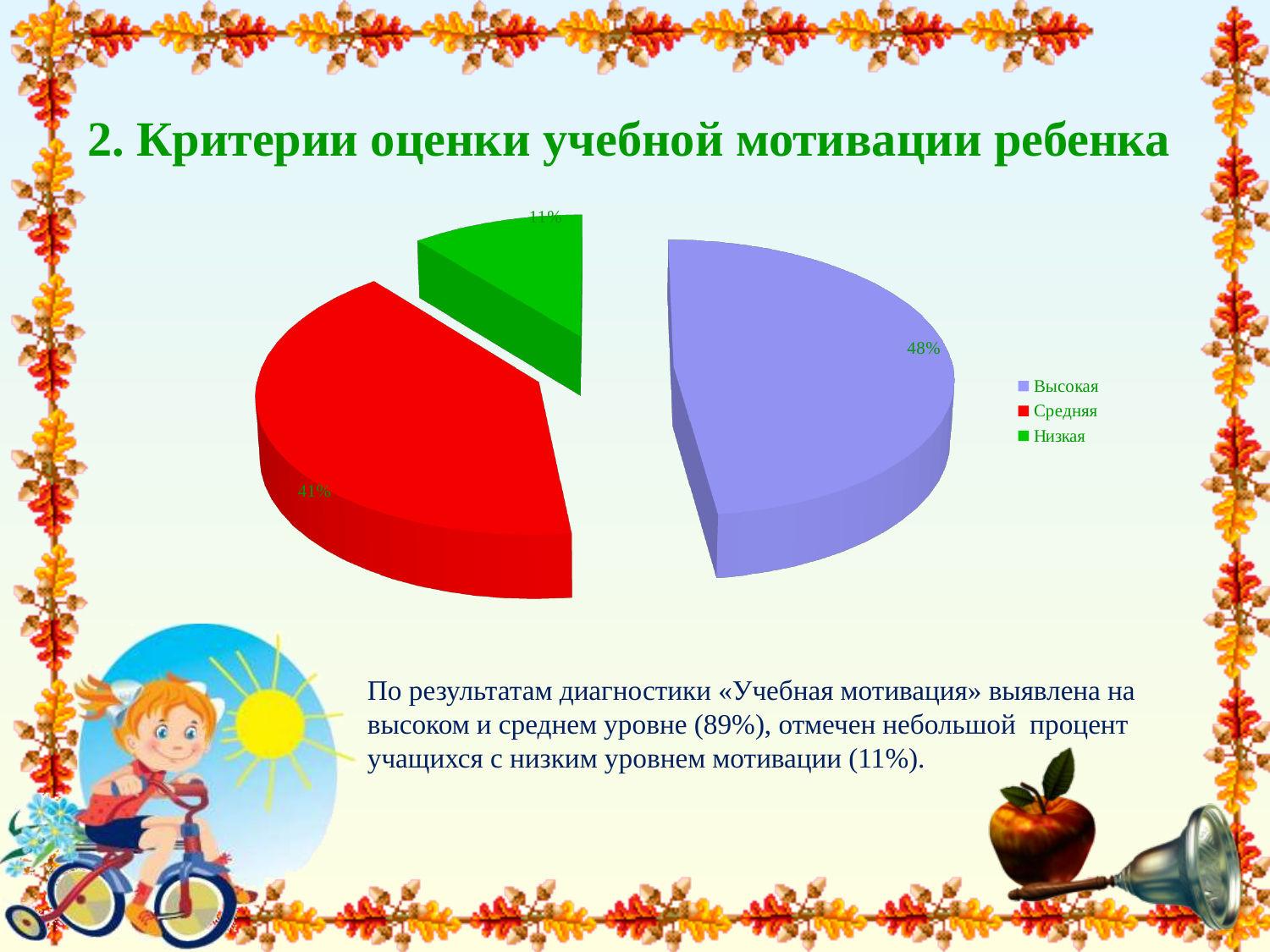
What share of the pie does the "Низкая" slice represent? 11% How many entries does the chart legend list? 3 Which slice is larger, "Средняя" or "Низкая"? Средняя Which category has the largest slice of the pie? Высокая What kind of chart is shown on the slide? pie chart What is the difference in percentage points between the "Высокая" and "Низкая" slices? 37 What is the difference in percentage points between the "Высокая" and "Средняя" slices? 7 How many slices does the pie chart have? 3 Which category has the smallest slice of the pie? Низкая What share of the pie does the "Высокая" slice represent? 48% What share of the pie does the "Средняя" slice represent? 41% What colour is the "Средняя" slice in the pie chart? red